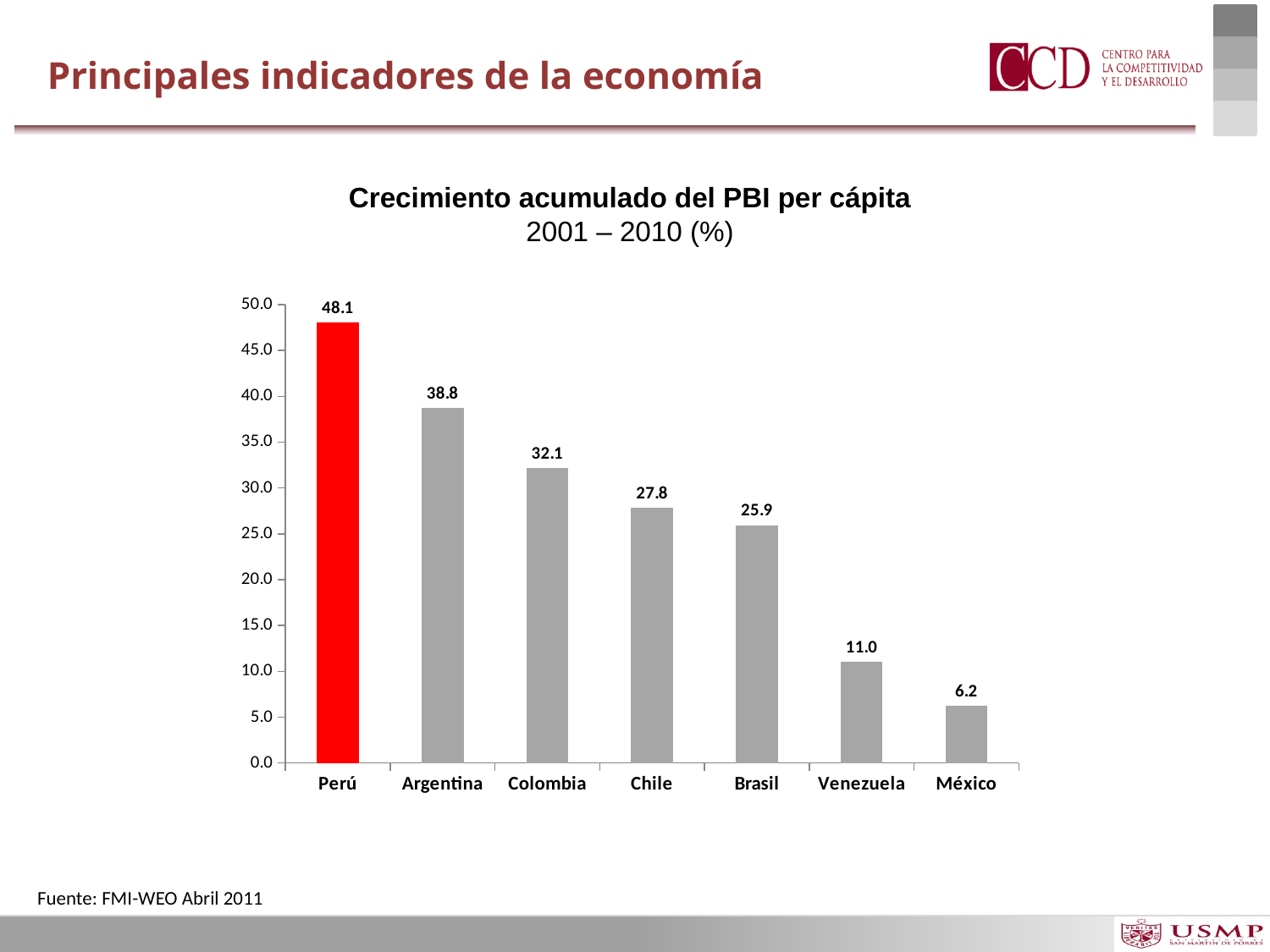
What is the difference between the values for Colombia and Brasil? 6.2 What is the value for Venezuela? 11.0 What is the value for Chile? 27.8 Which country has the highest value? Perú What is the difference between the values for Perú and Argentina? 9.3 Is the value for Argentina greater or less than 35.0? greater How many countries are shown in the chart? 7 What is the value for Perú? 48.1 Which bar is coloured red? Perú What kind of chart is shown on the slide? Bar chart Which country has the lowest value? México Which is larger, the value for Chile or the value for Brasil? Chile